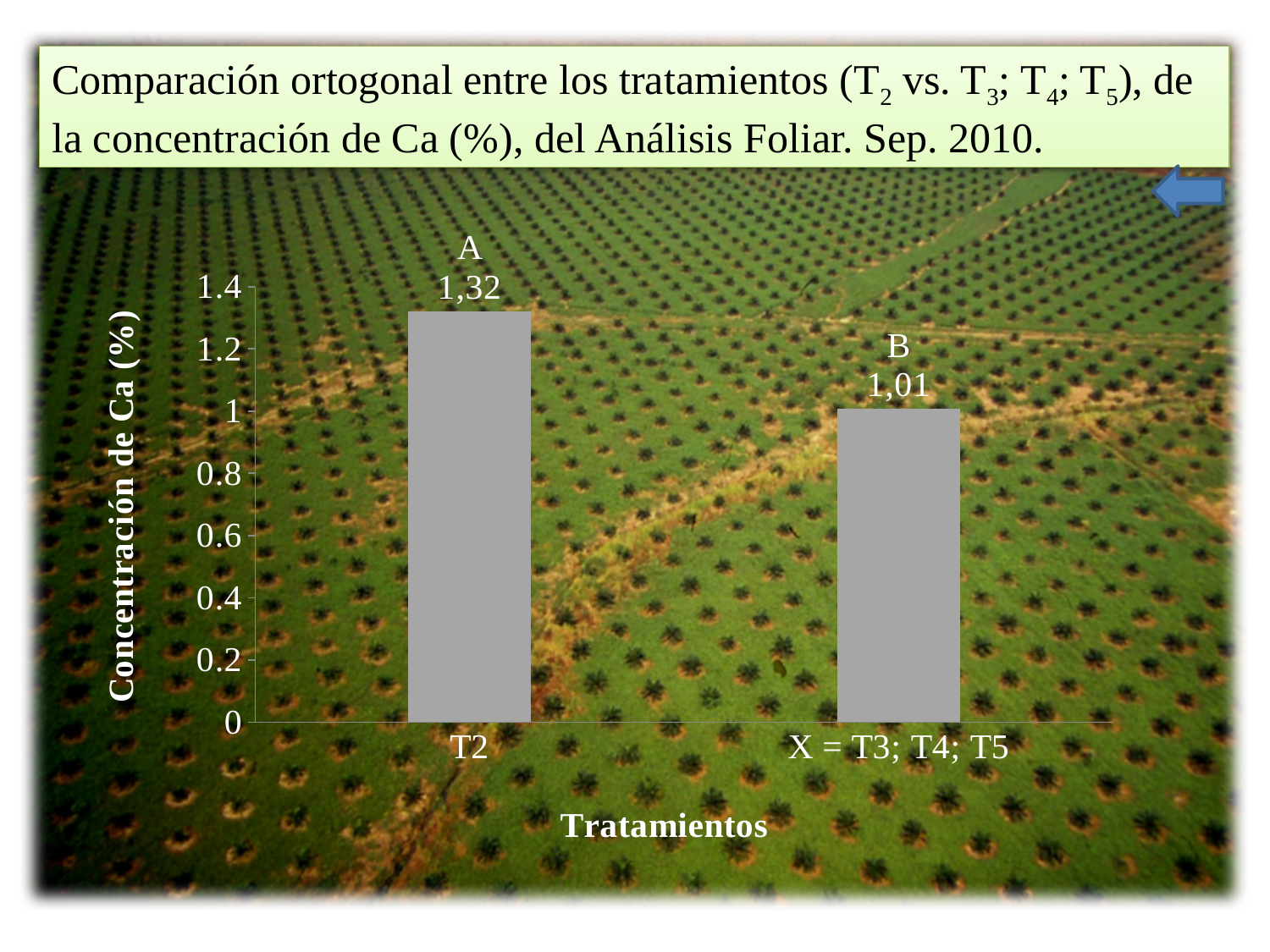
What is the label of the y axis? Concentración de Ca (%) Is the value for X = T3; T4; T5 greater or less than 1.2? less What statistical group letter is shown above the bar for X = T3; T4; T5? B Which treatment category has the highest Ca concentration? T2 What is the Ca concentration value shown for X = T3; T4; T5? 1,01 Which treatment category has the lowest Ca concentration? X = T3; T4; T5 How many bars are plotted in the chart? 2 Which has a larger Ca concentration, T2 or X = T3; T4; T5? T2 What kind of chart is shown on the slide? Bar chart Is the value for T2 greater or less than 1.2? greater What is the difference between the Ca concentration for T2 and for X = T3; T4; T5? 0,31 What is the Ca concentration value shown for T2? 1,32